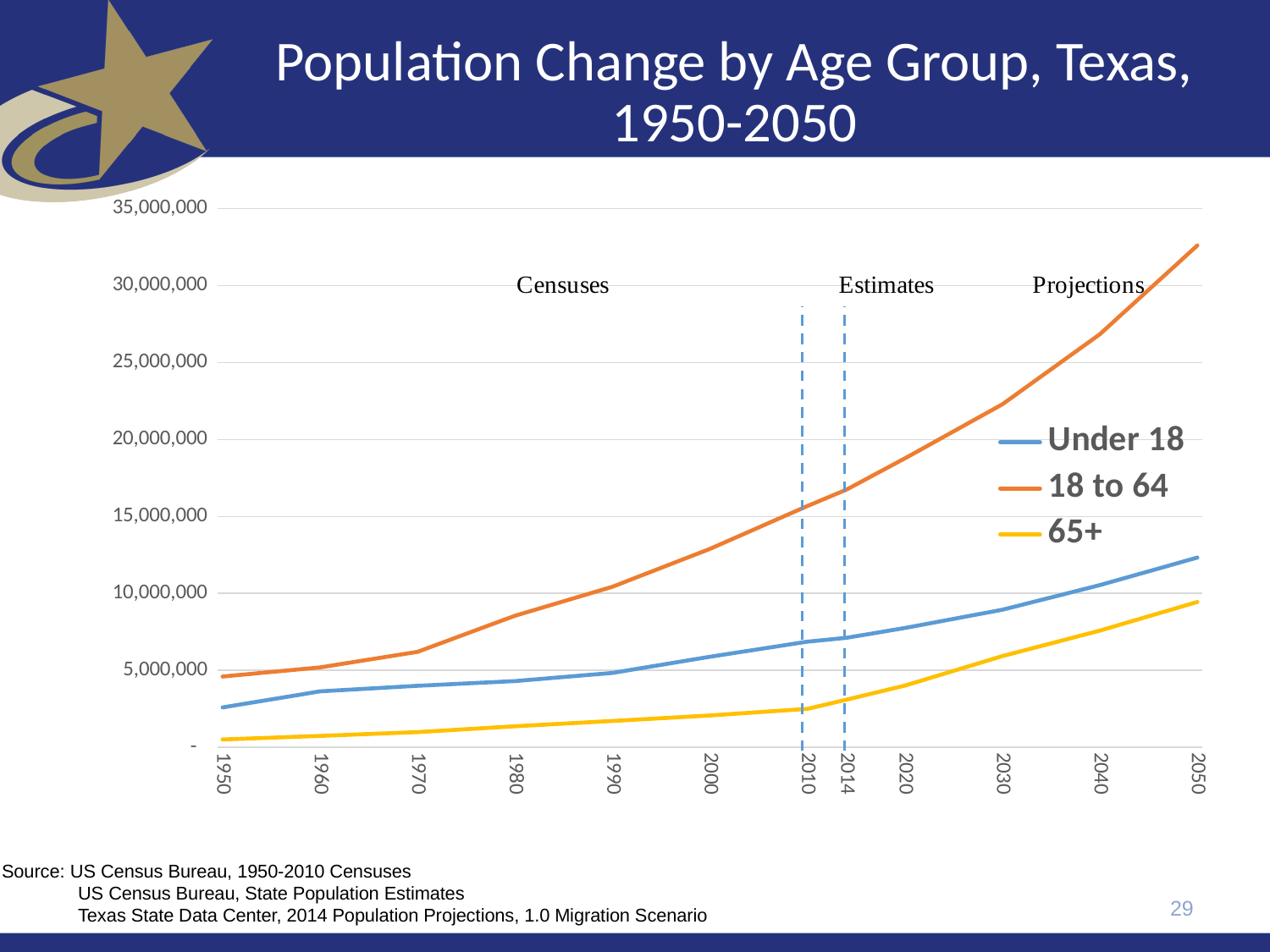
Does the 18 to 64 line rise or fall from 1950 to 2050? rises Is the value for 18 to 64 in 2050 greater or less than 30,000,000? greater Which age group has the lowest population in 1950? 65+ In 2050, which is larger: the Under 18 population or the 65+ population? Under 18 Is the value for Under 18 in 2050 greater or less than 10,000,000? greater How many years are marked along the x axis? 12 Is the value for 18 to 64 in 2000 greater or less than 15,000,000? less What colour is the line for the 65+ series? yellow How many series does the legend list? 3 What kind of chart is shown on the slide? line chart Which age group has the highest population in 2050? 18 to 64